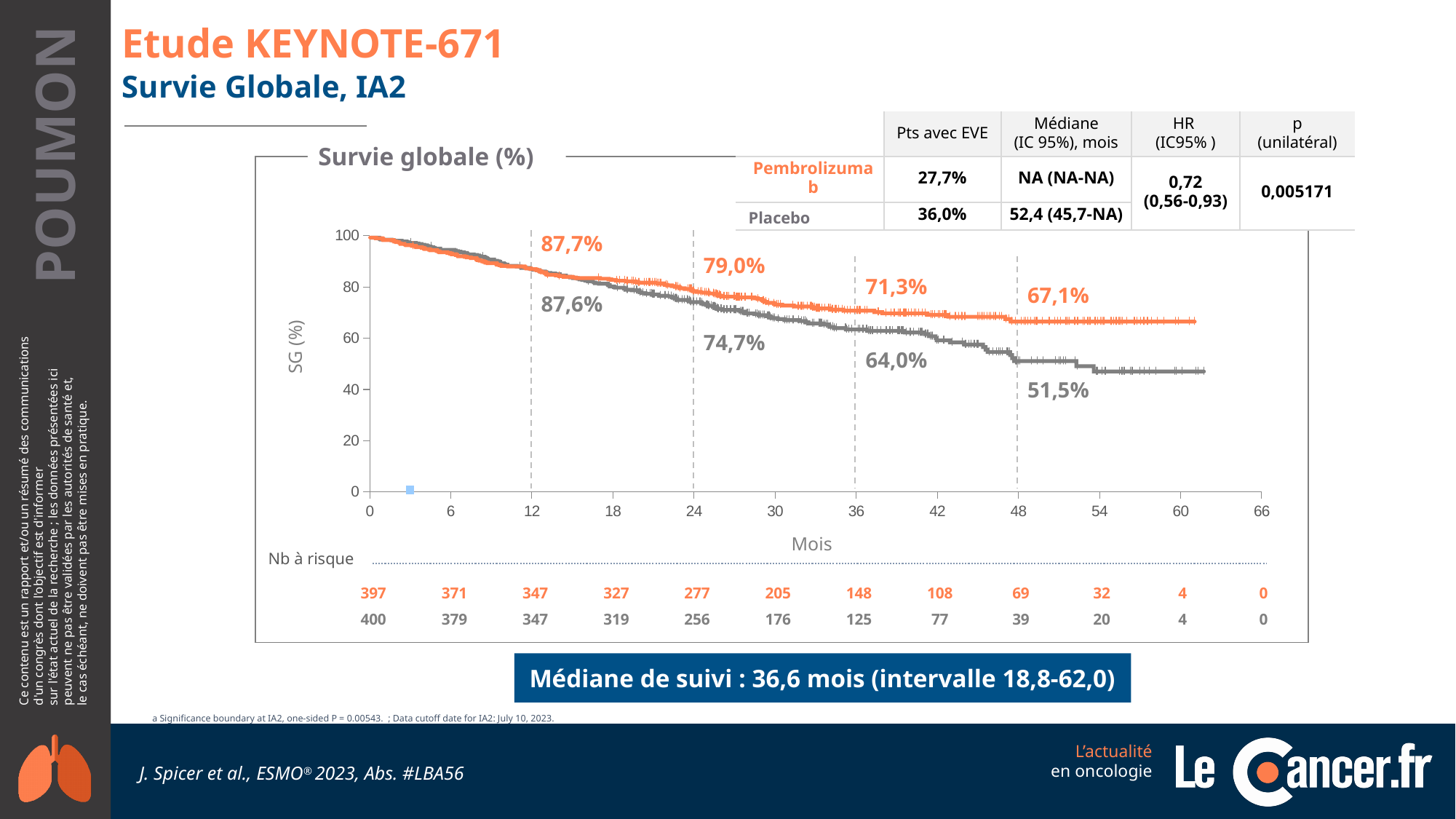
What type of chart is shown on the slide? Line chart (Kaplan-Meier survival curve) At 36 months, which arm has the higher overall survival rate, pembrolizumab or placebo? Pembrolizumab How many patients were at risk in the pembrolizumab arm at 30 months? 205 What is the overall survival rate for the placebo arm at 12 months? 87,6% How many patients were at risk in the placebo arm at 0 months? 400 Do the survival curves rise or fall as months increase? Fall What is the overall survival rate for the pembrolizumab arm at 24 months? 79,0% What is the overall survival rate for the placebo arm at 36 months? 64,0% What is the difference in overall survival between pembrolizumab and placebo at 24 months? 4,3 points What is the overall survival rate for the pembrolizumab arm at 48 months? 67,1% What is the label of the y axis of the chart? SG (%) What is the difference in overall survival between pembrolizumab and placebo at 48 months? 15,6 points